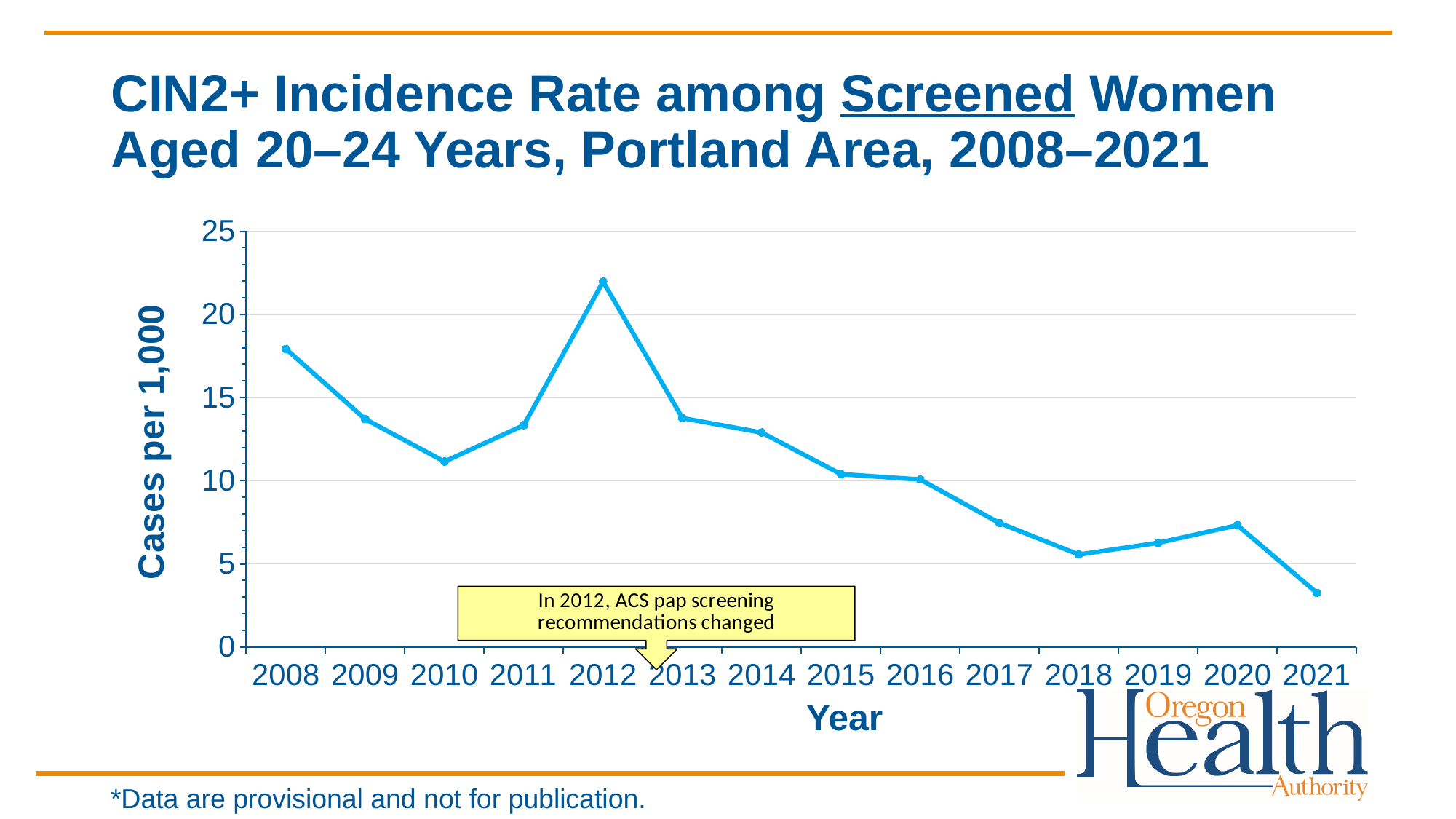
Is the value for 2012 greater or less than 20? greater Is the value for 2017 greater or less than 10? less Is the value for 2021 greater or less than 5? less How many years (data points) are plotted on the chart? 14 Which year has the highest CIN2+ incidence rate? 2012 Overall, does the incidence rate rise or fall from 2008 to 2021? fall Which year has a higher incidence rate, 2008 or 2009? 2008 What kind of chart is shown on the slide? line chart Which year has a higher incidence rate, 2020 or 2021? 2020 Which year has the lowest CIN2+ incidence rate? 2021 What is the label on the y-axis of the chart? Cases per 1,000